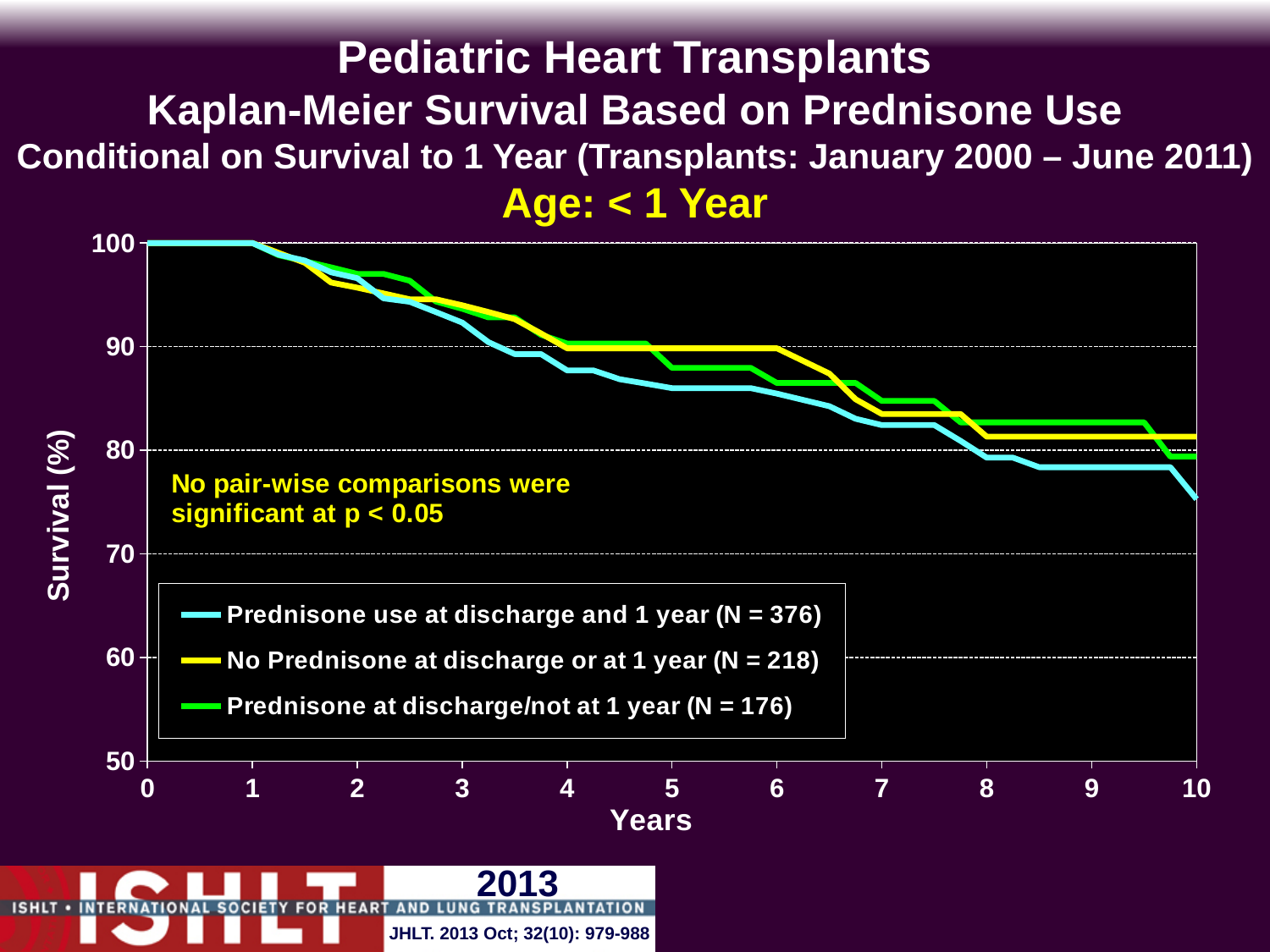
What is the N for the 'No Prednisone at discharge or at 1 year' group? 218 What kind of chart is shown on the slide? Line chart Is the survival value for 'Prednisone use at discharge and 1 year' at 5 years greater or less than 90? less At 5 years, which is higher: survival for 'Prednisone use at discharge and 1 year' or 'No Prednisone at discharge or at 1 year'? No Prednisone at discharge or at 1 year Is the survival value for 'Prednisone use at discharge and 1 year' at 10 years greater or less than 80? less What is the N for the 'Prednisone at discharge/not at 1 year' group? 176 At 10 years, which group has the lowest survival? Prednisone use at discharge and 1 year Do the survival curves rise or fall as years increase? Fall What is the label of the y axis? Survival (%) What is the N for the 'Prednisone use at discharge and 1 year' group? 376 How many series does the legend list? 3 Is the survival value for 'Prednisone at discharge/not at 1 year' at 3 years greater or less than 90? greater